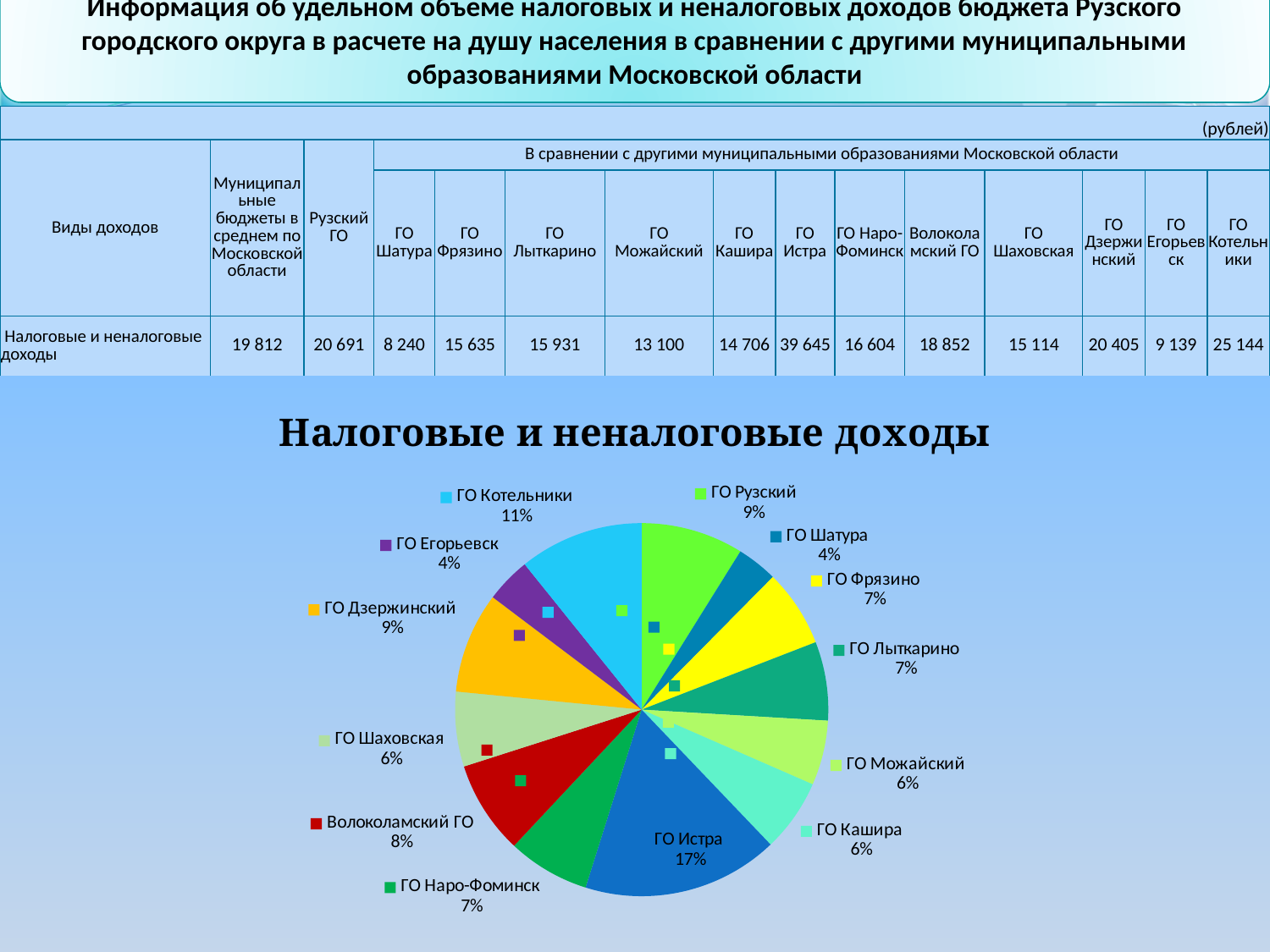
What percentage is shown for Волоколамский ГО? 8% What percentage is shown for ГО Котельники? 11% Which slice of the pie is the largest? ГО Истра Which is larger, the share for ГО Котельники or the share for ГО Дзержинский? ГО Котельники What type of chart is shown on the slide? Pie chart What percentage is shown for ГО Наро-Фоминск? 7% What percentage is shown for ГО Шатура? 4% What share of the pie does ГО Истра account for? 17% What percentage is shown for ГО Дзержинский? 9% How many slices does the pie chart have? 13 What is the title of the chart? Налоговые и неналоговые доходы What is the difference in percentage points between the share for ГО Истра and the share for ГО Котельники? 6